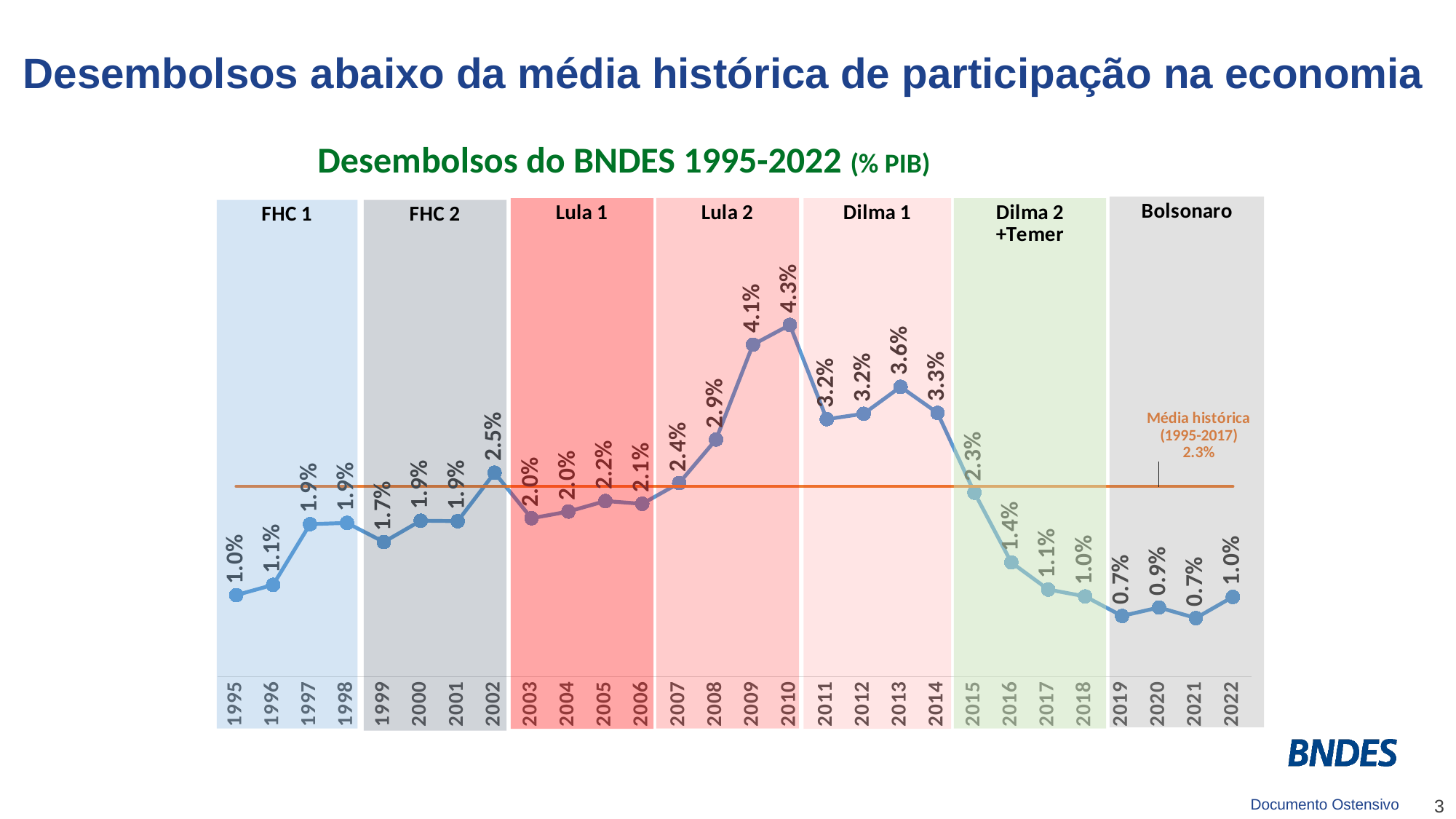
What is the value shown for 2019? 0.7% How many years (data points) are plotted in the chart? 28 How many presidential periods are labelled across the top of the chart? 7 What is the value of BNDES disbursements as % of GDP in 2010? 4.3% What is the value shown for 2002? 2.5% What type of chart is shown on the slide? Line chart What is the lowest value shown in the chart? 0.7% What is the historical average (Média histórica 1995-2017) shown on the chart? 2.3% Do the values rise or fall from 2014 to 2019? Fall What is the difference between the values for 2010 and 2022? 3.3% Which year has a larger value, 2009 or 2013? 2009 Which year has the highest value in the chart? 2010